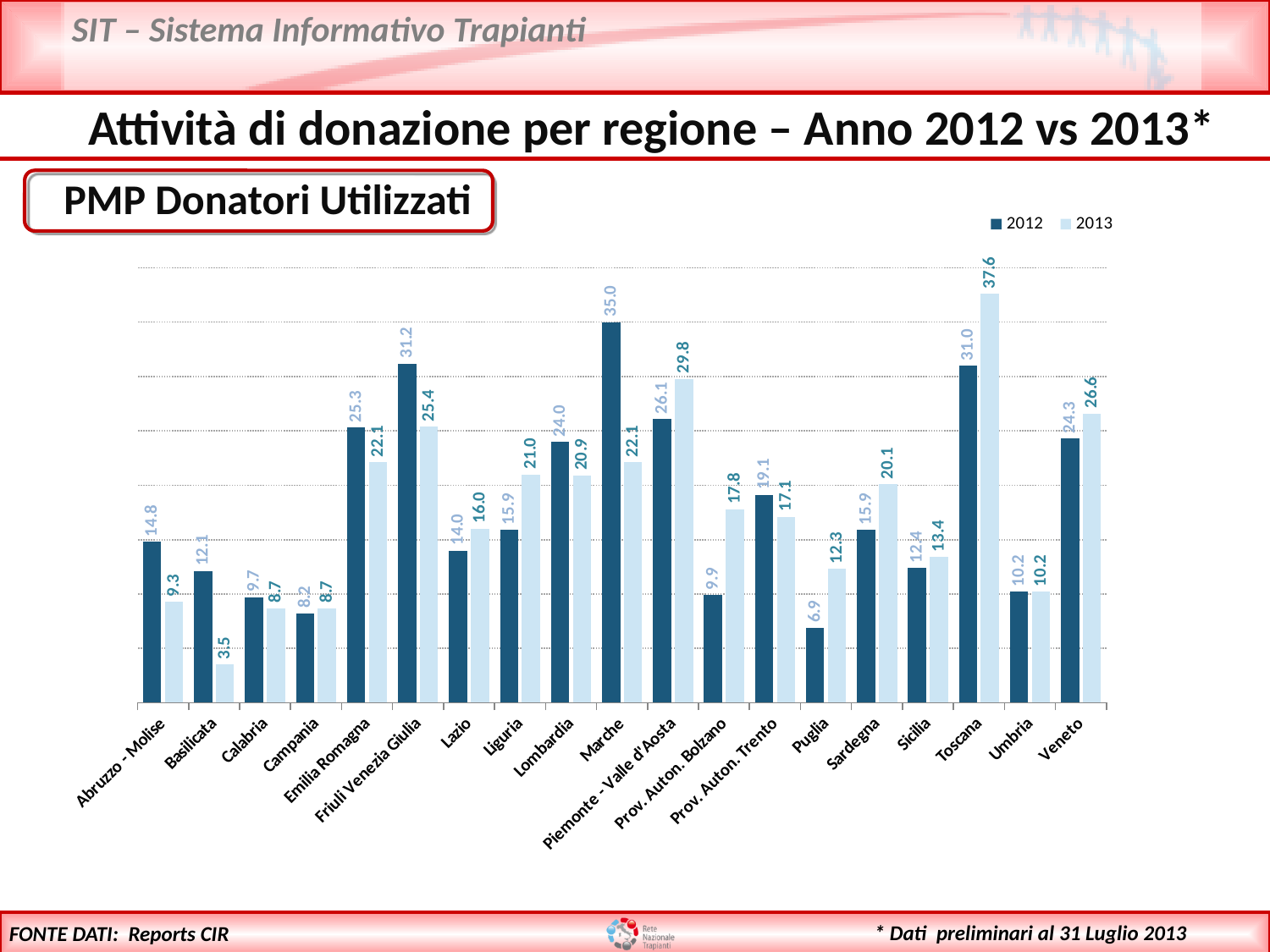
What is the 2013 value for Toscana? 37.6 What is the 2012 value for Prov. Auton. Bolzano? 9.9 What kind of chart is shown? Bar chart Which is larger for Piemonte - Valle d'Aosta, the 2012 value or the 2013 value? 2013 Which region has the lowest 2012 value? Puglia What is the 2013 value for Basilicata? 3.5 Which region has the highest 2013 value? Toscana What is the 2012 value for Marche? 35.0 How many series does the legend list? 2 How many regions are shown on the x axis? 19 What are the two series listed in the legend? 2012 and 2013 What is the difference between the 2012 and 2013 values for Marche? 12.9